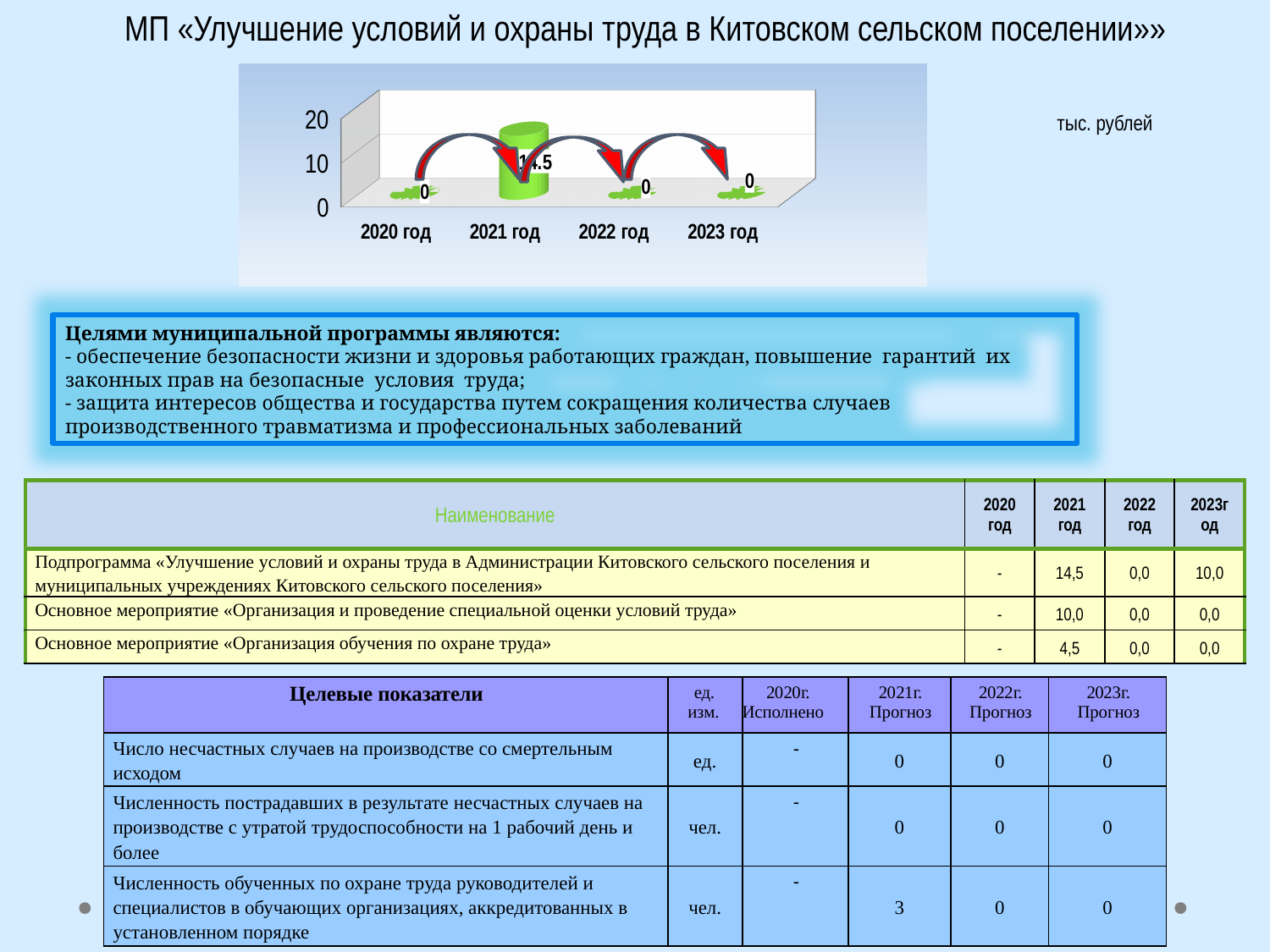
What is the value shown for 2023 год on the chart? 0 What kind of chart is shown on the slide? bar chart What is the value shown for 2020 год on the chart? 0 What unit of measurement is indicated next to the chart? тыс. рублей Do the values on the chart rise or fall from 2021 год to 2022 год? fall Which is larger on the chart, the value for 2021 год or the value for 2022 год? 2021 год Which year has the highest value on the chart? 2021 год What is the value shown for 2022 год on the chart? 0 What is the difference between the values for 2021 год and 2020 год on the chart? 14.5 How many year categories are shown on the chart's x axis? 4 Is the value for 2021 год greater or less than 10? greater What is the value shown for 2021 год on the chart? 14.5